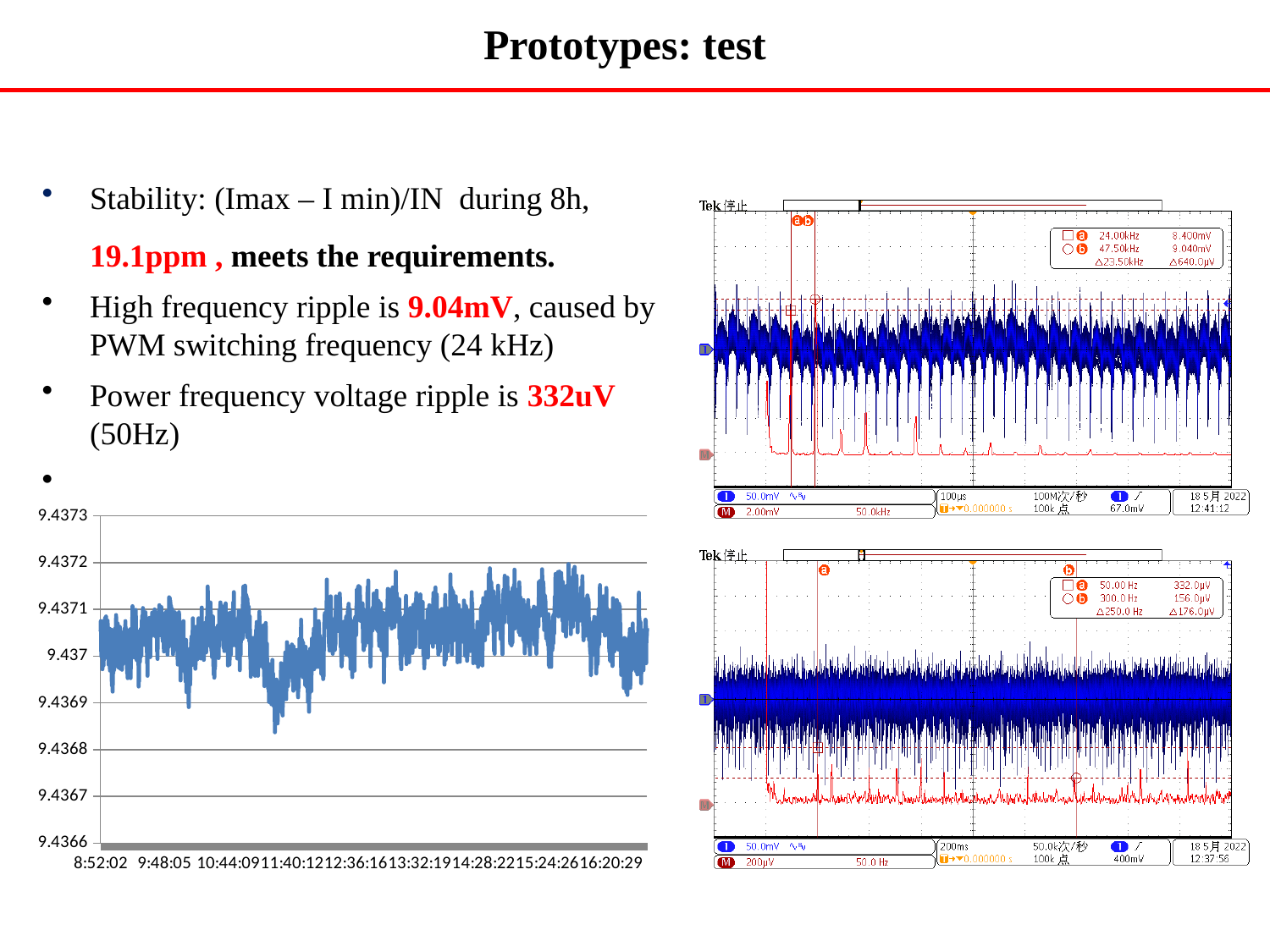
In the bottom-left line chart, what is the first time label on the x axis? 8:52:02 In the bottom-left line chart, is the value at 16:20:29 greater or less than 9.4372? less How many time labels are shown on the x axis of the bottom-left line chart? 9 In the bottom oscilloscope screenshot, what voltage is shown for cursor a at 50.00 Hz? 332.0µV What kind of chart is shown at the bottom left of the slide? line chart In the top oscilloscope screenshot, what frequency is shown for cursor a? 24.00kHz In the bottom-left line chart, what is the last time label on the x axis? 16:20:29 In the bottom-left line chart, what is the lowest value labelled on the y axis? 9.4366 In the bottom-left line chart, what is the highest value labelled on the y axis? 9.4373